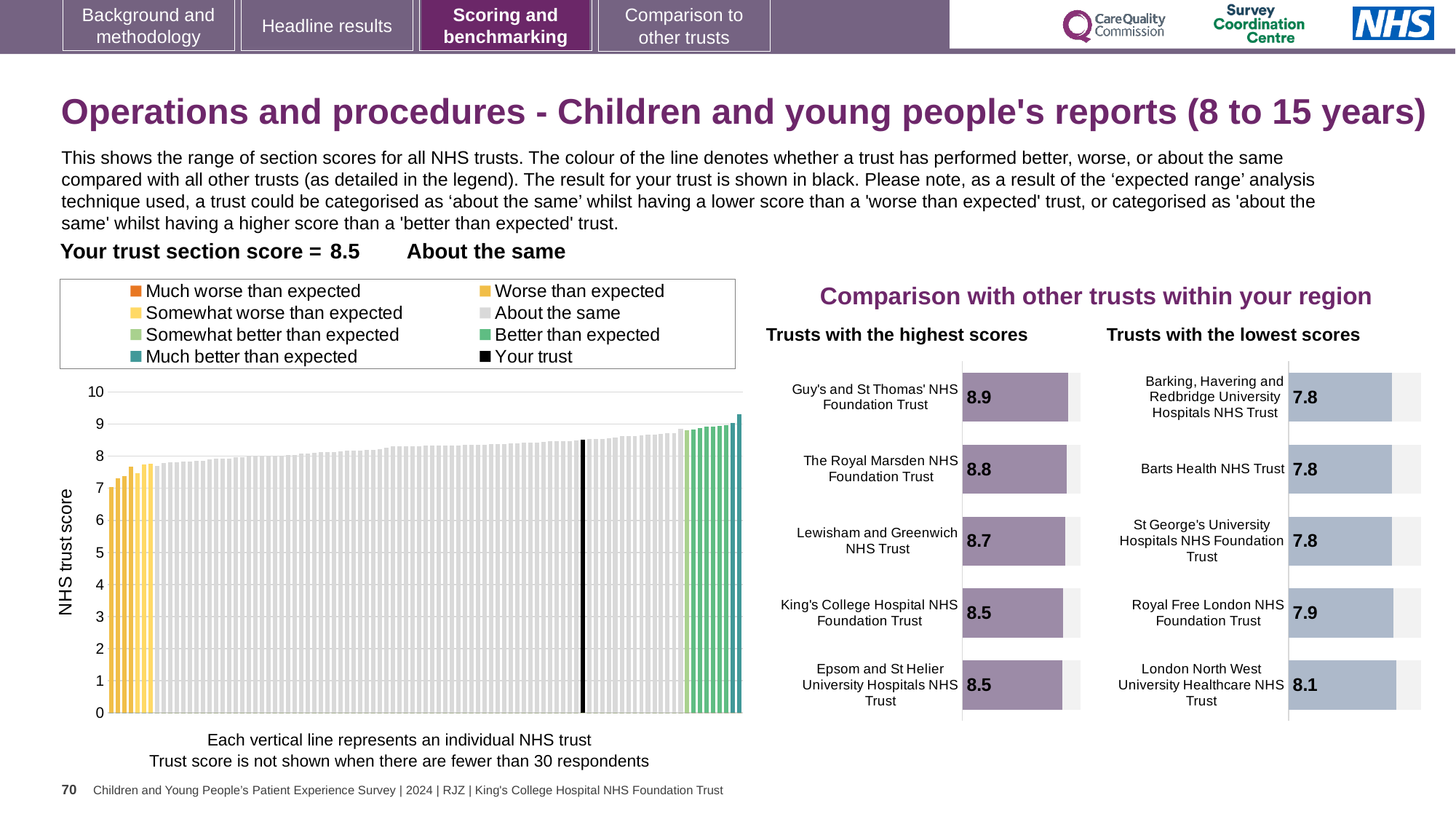
In the 'Trusts with the highest scores' chart, which trust has the highest score? Guy's and St Thomas' NHS Foundation Trust In the 'Trusts with the highest scores' chart, what is the difference between the scores of Guy's and St Thomas' NHS Foundation Trust and Lewisham and Greenwich NHS Trust? 0.2 In the 'Trusts with the lowest scores' chart, which trust has the highest score? London North West University Healthcare NHS Trust In the large 'NHS trust score' chart on the left, do the bar values rise or fall from left to right? rise In the 'Trusts with the highest scores' chart, what is the score for Guy's and St Thomas' NHS Foundation Trust? 8.9 How many entries does the legend of the large 'NHS trust score' chart on the left list? 8 In the large 'NHS trust score' chart on the left, is the value for the black 'Your trust' bar greater or less than 8? greater How many trusts are shown in the 'Trusts with the highest scores' chart? 5 In the 'Trusts with the lowest scores' chart, what is the score for Royal Free London NHS Foundation Trust? 7.9 In the 'Trusts with the lowest scores' chart, what is the score for London North West University Healthcare NHS Trust? 8.1 In the 'Trusts with the highest scores' chart, what is the score for Lewisham and Greenwich NHS Trust? 8.7 In the 'Trusts with the lowest scores' chart, what is the difference between the scores of London North West University Healthcare NHS Trust and Barts Health NHS Trust? 0.3